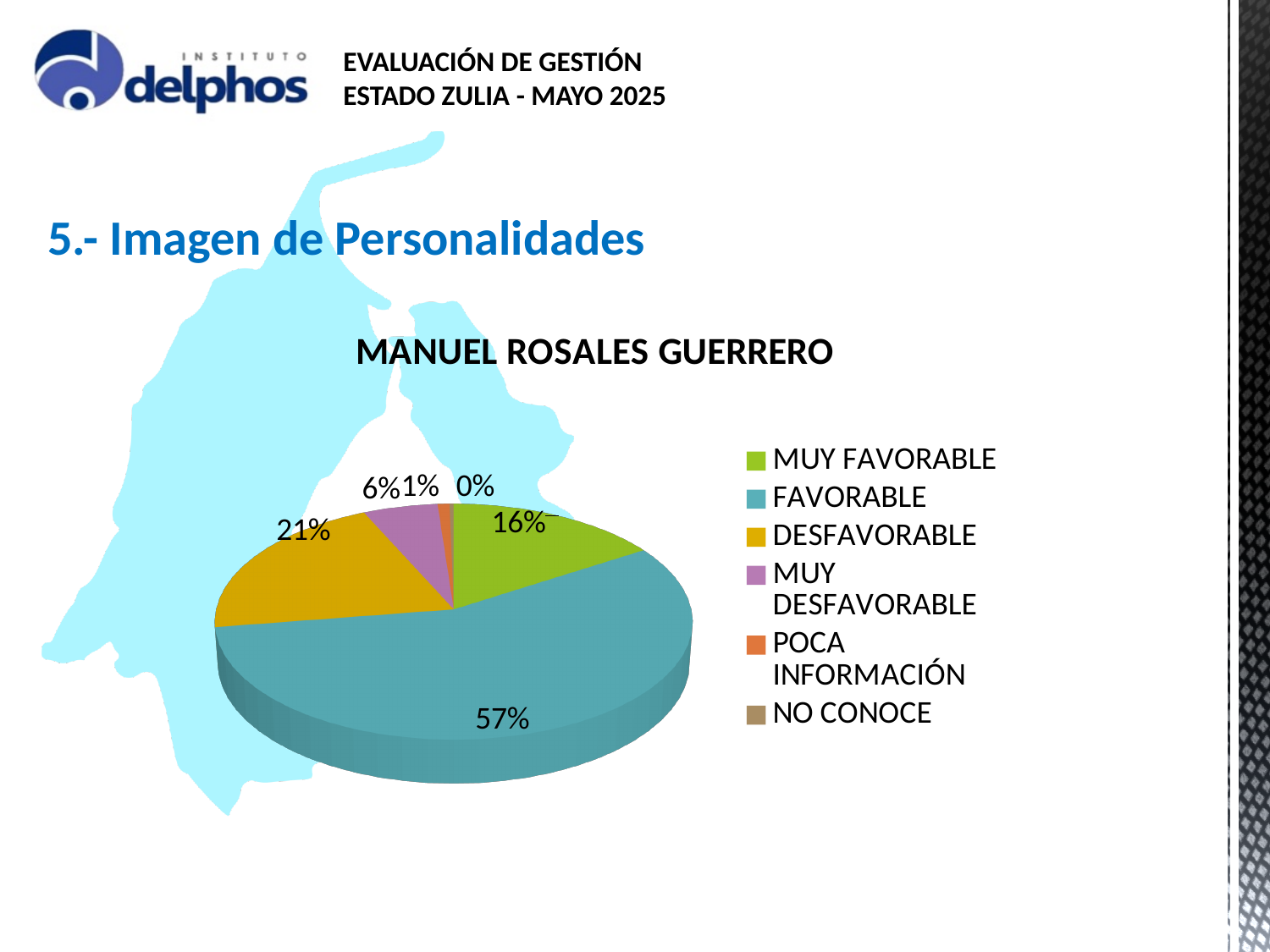
Which category has the smallest share of the pie? NO CONOCE What percentage of the pie is MUY FAVORABLE? 16% How many categories does the legend list? 6 What is the title of the chart? MANUEL ROSALES GUERRERO Which category has the largest share of the pie? FAVORABLE What percentage of the pie is MUY DESFAVORABLE? 6% What percentage of the pie is FAVORABLE? 57% What percentage of the pie is POCA INFORMACIÓN? 1% What is the difference between the FAVORABLE and DESFAVORABLE shares? 36% Which is larger, the MUY FAVORABLE share or the DESFAVORABLE share? DESFAVORABLE What percentage of the pie is DESFAVORABLE? 21% What type of chart is shown on the slide? pie chart